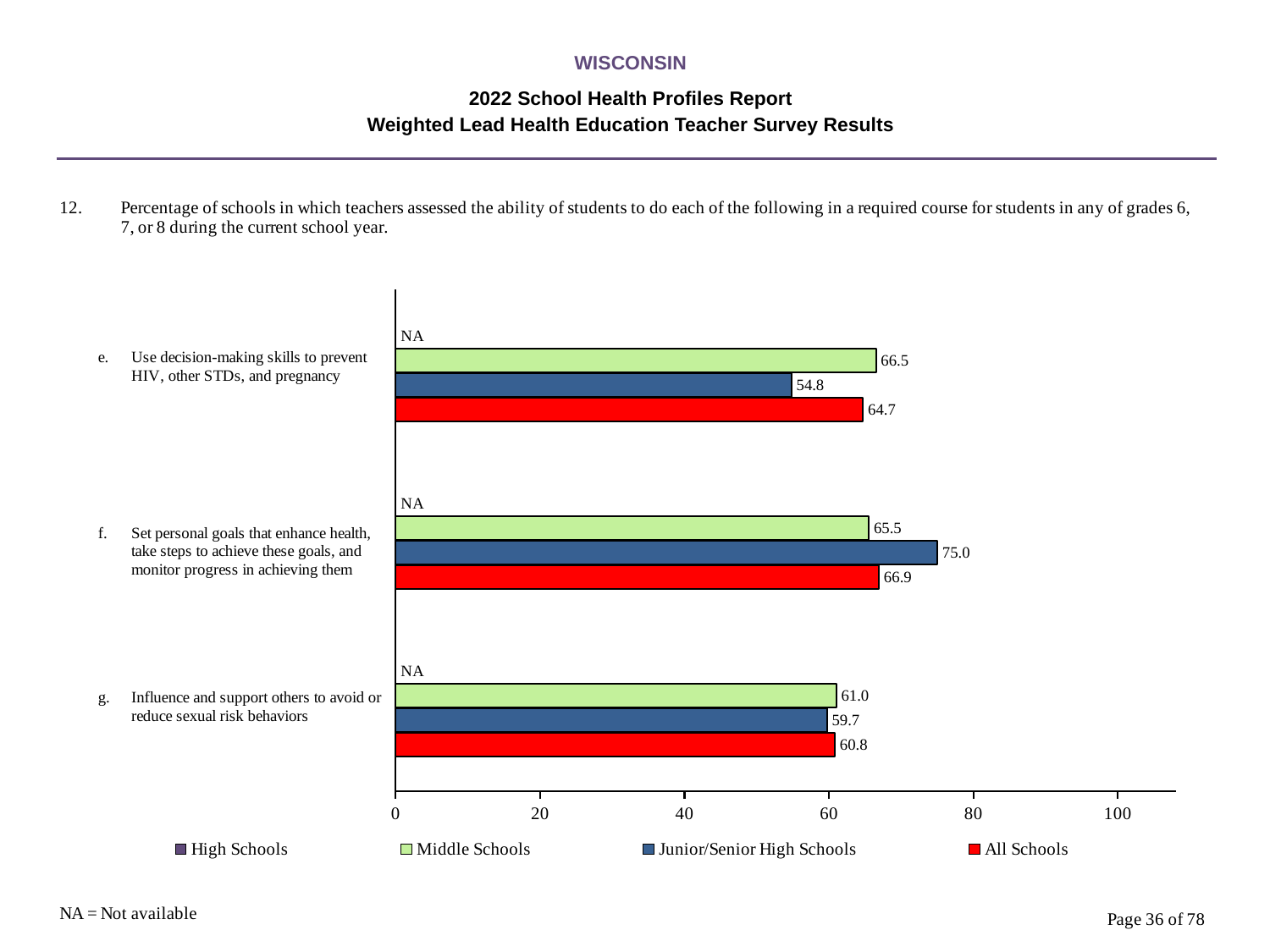
Which item has the lowest Middle Schools value? g. Influence and support others to avoid or reduce sexual risk behaviors What is the All Schools value for item g, 'Influence and support others to avoid or reduce sexual risk behaviors'? 60.8 Which item has the highest Junior/Senior High Schools value? f. Set personal goals that enhance health, take steps to achieve these goals, and monitor progress in achieving them How many items (categories) are shown on the chart? 3 What is the difference between the Junior/Senior High Schools value and the Middle Schools value for item f? 9.5 What kind of chart is shown on the slide? bar chart For item e, which is larger: the Middle Schools value or the Junior/Senior High Schools value? Middle Schools What is the Middle Schools value for item e, 'Use decision-making skills to prevent HIV, other STDs, and pregnancy'? 66.5 What value is shown for High Schools for item e? NA Is the Junior/Senior High Schools value for item e greater or less than 60? less How many series does the legend list? 4 What is the Junior/Senior High Schools value for item f, 'Set personal goals that enhance health, take steps to achieve these goals, and monitor progress in achieving them'? 75.0